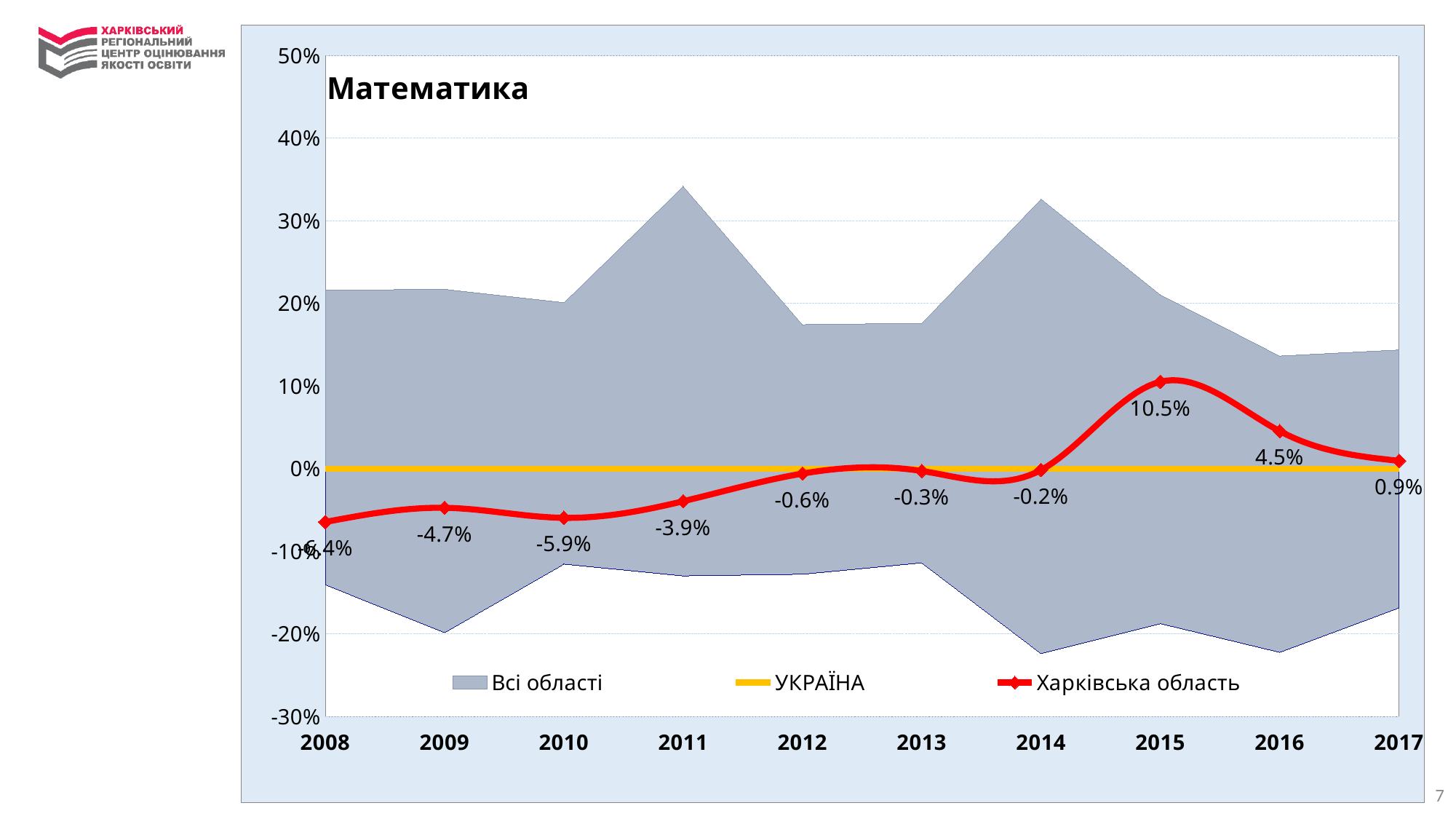
How many years are shown on the x axis? 10 What is the value for Харківська область in 2012? -0.6% Does the Харківська область line rise or fall from 2012 to 2015? rise How many series does the legend list? 3 What is the title of the chart? Математика What is the value for Харківська область in 2017? 0.9% What is the value for Харківська область in 2015? 10.5% In which year does Харківська область reach its highest value? 2015 What is the value for Харківська область in 2010? -5.9% Which year has the higher value for Харківська область, 2009 or 2010? 2009 By how many percentage points did the Харківська область value fall from 2015 to 2016? 6.0 percentage points Is the upper edge of the Всі області band in 2011 greater or less than 30%? greater